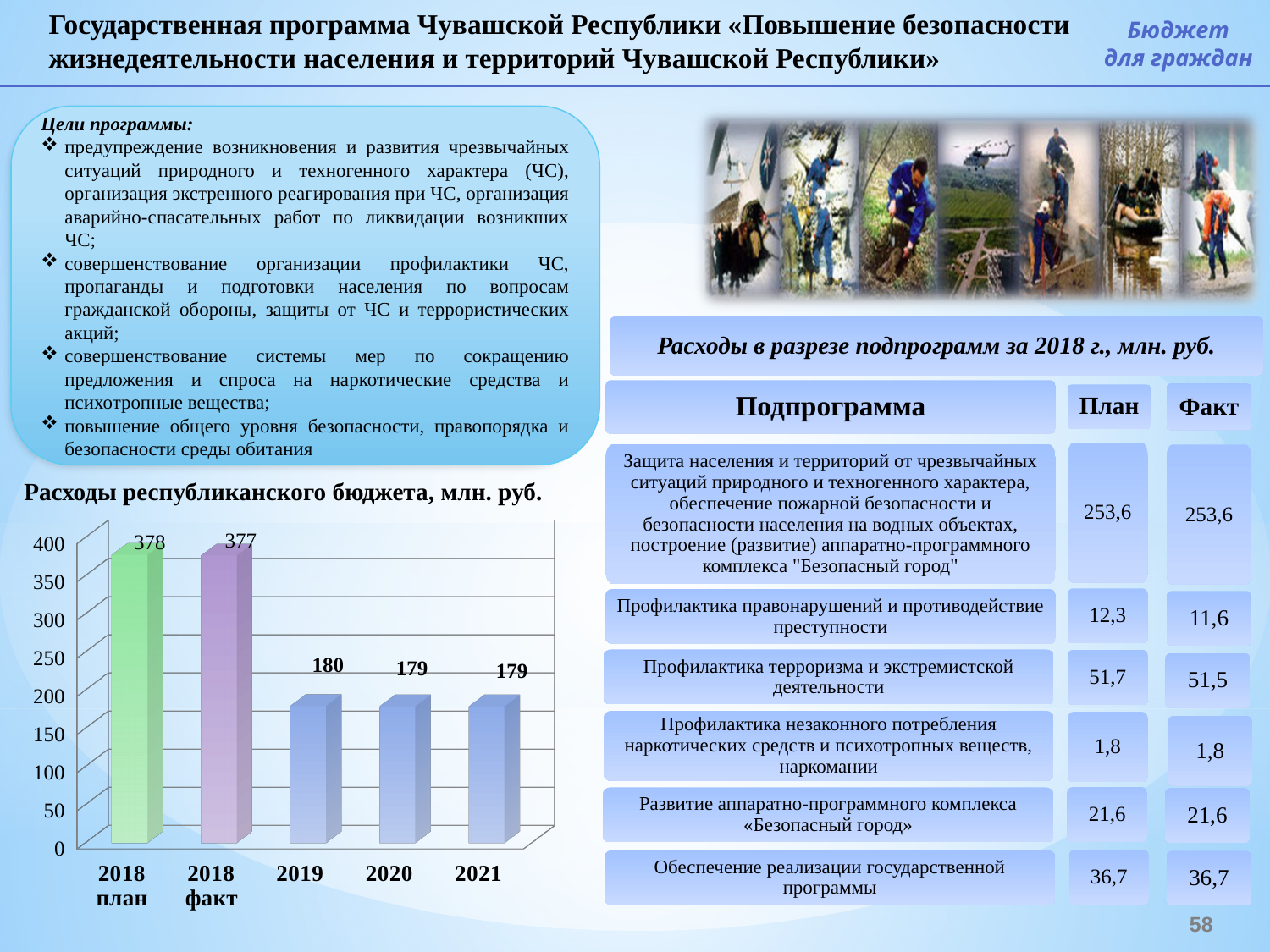
How many categories are shown on the x axis of the chart? 5 Which is larger, the value for 2018 факт or the value for 2020? 2018 факт What is the value for 2021 in the chart? 179 What is the title of the chart? Расходы республиканского бюджета, млн. руб. What is the value for 2019 in the chart? 180 What type of chart is shown on the slide? bar chart What is the value for 2018 план in the chart? 378 What is the difference between the values for 2018 план and 2019? 198 What is the value for 2018 факт in the chart? 377 Is the value for 2020 greater or less than 200? less Which category has the highest value in the chart? 2018 план What is the difference between the values for 2019 and 2020? 1